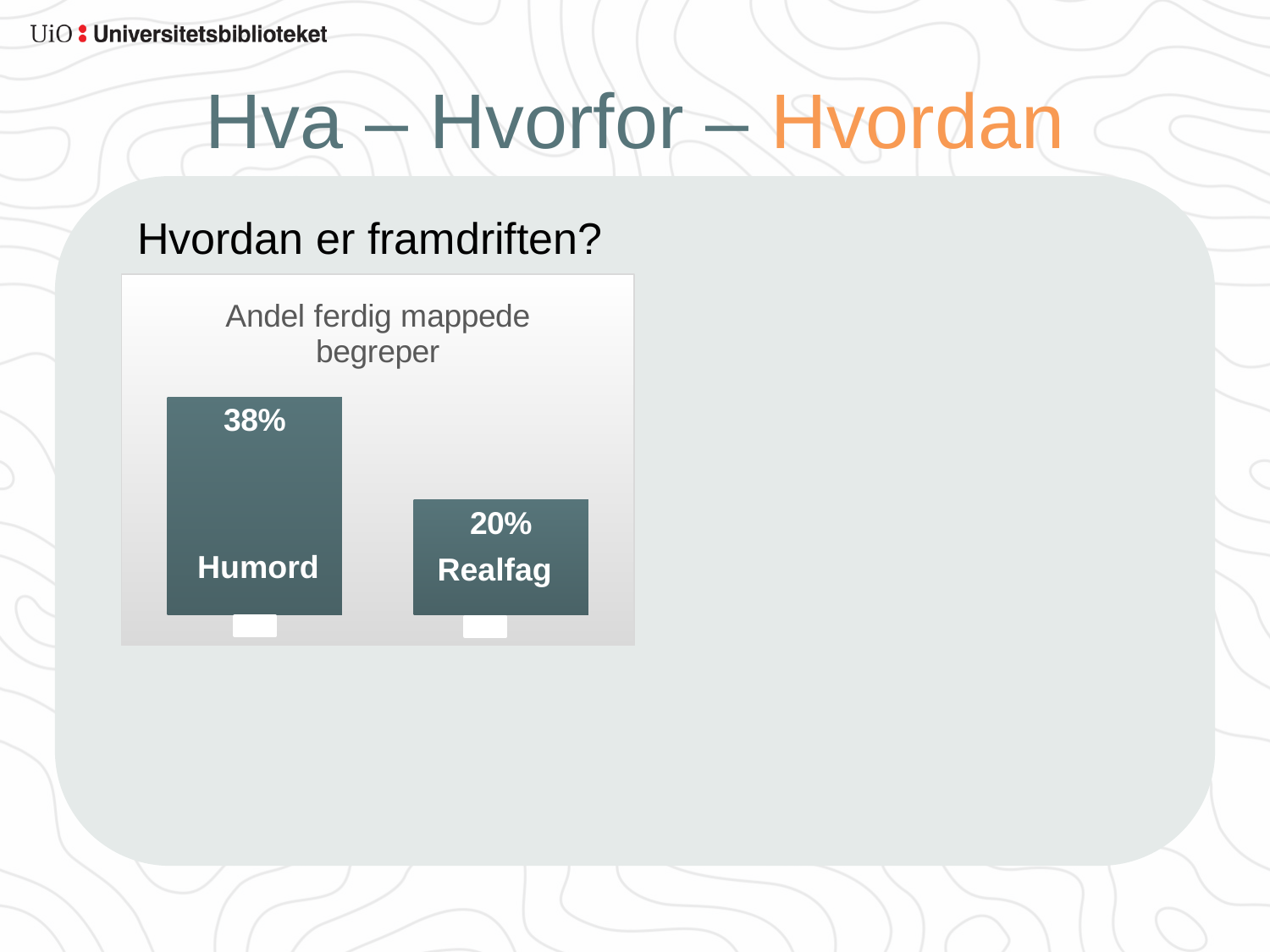
Which category has the lowest value in the chart? Realfag What is the value for Humord in the chart? 38% Do the values rise or fall from Humord to Realfag? Fall How many categories are shown in the chart? 2 What kind of chart is shown on the slide? Bar chart What is the value for Realfag in the chart? 20% What is the difference between the values for Humord and Realfag? 18% Which category has the highest value in the chart? Humord What is the title of the chart? Andel ferdig mappede begreper Which is larger, the value for Humord or the value for Realfag? Humord